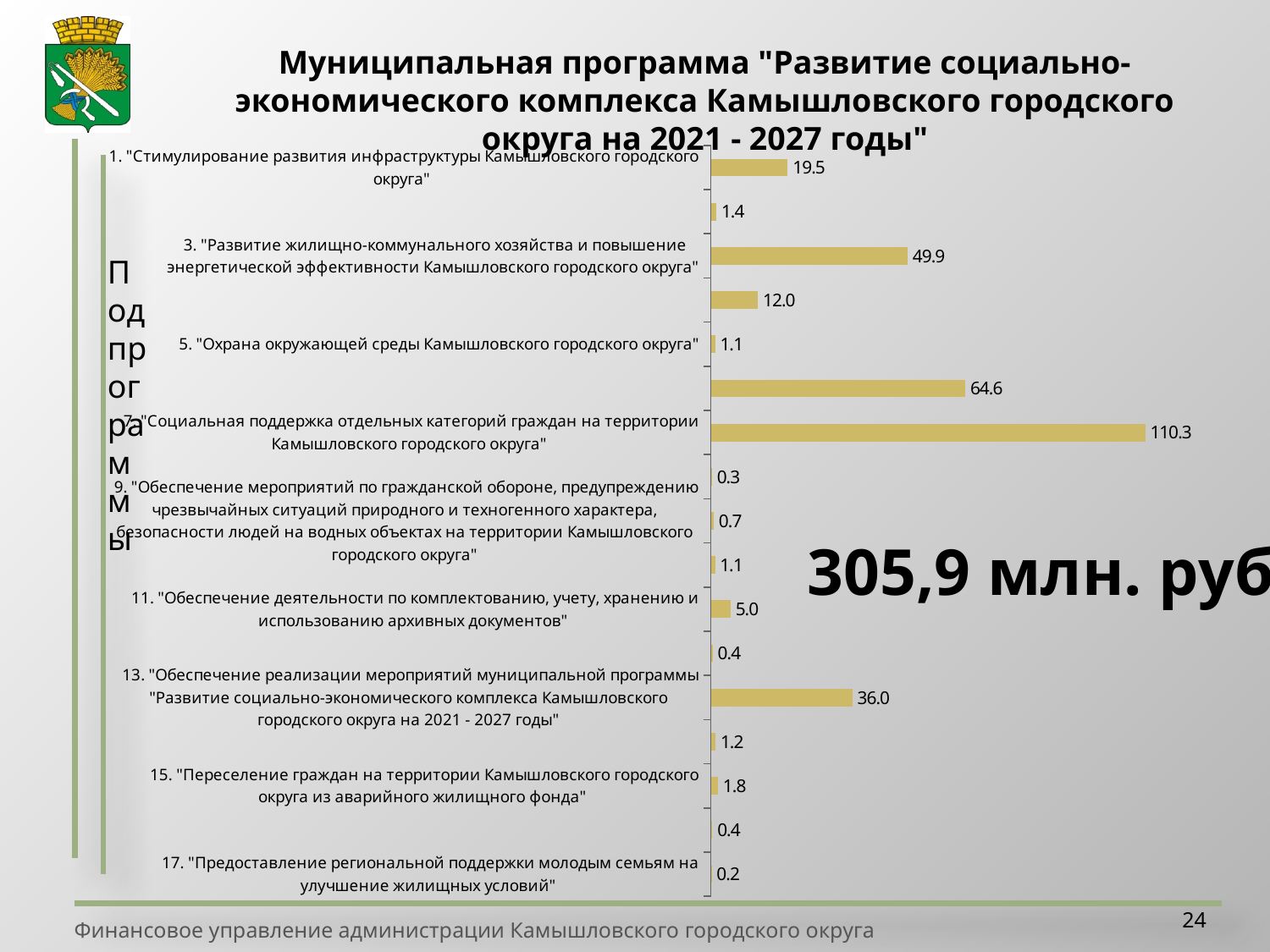
What is the value for subprogram 11 "Обеспечение деятельности по комплектованию, учету, хранению и использованию архивных документов"? 5.0 Which is larger: the value for subprogram 13 or the value for subprogram 1? Subprogram 13 What is the value for subprogram 7 "Социальная поддержка отдельных категорий граждан на территории Камышловского городского округа"? 110.3 How many bars are plotted in the chart? 17 What is the value for subprogram 13 "Обеспечение реализации мероприятий муниципальной программы..."? 36.0 What type of chart is shown on the slide? Bar chart Which subprogram has the highest value in the chart? 7. "Социальная поддержка отдельных категорий граждан на территории Камышловского городского округа" What total amount is printed in large text next to the chart? 305,9 млн. руб. What is the value for subprogram 3 "Развитие жилищно-коммунального хозяйства и повышение энергетической эффективности Камышловского городского округа"? 49.9 Which labeled subprogram has the lowest value in the chart? 17. "Предоставление региональной поддержки молодым семьям на улучшение жилищных условий" What is the value for subprogram 1 "Стимулирование развития инфраструктуры Камышловского городского округа"? 19.5 What is the difference between the values for subprogram 7 (110.3) and subprogram 3 (49.9)? 60.4